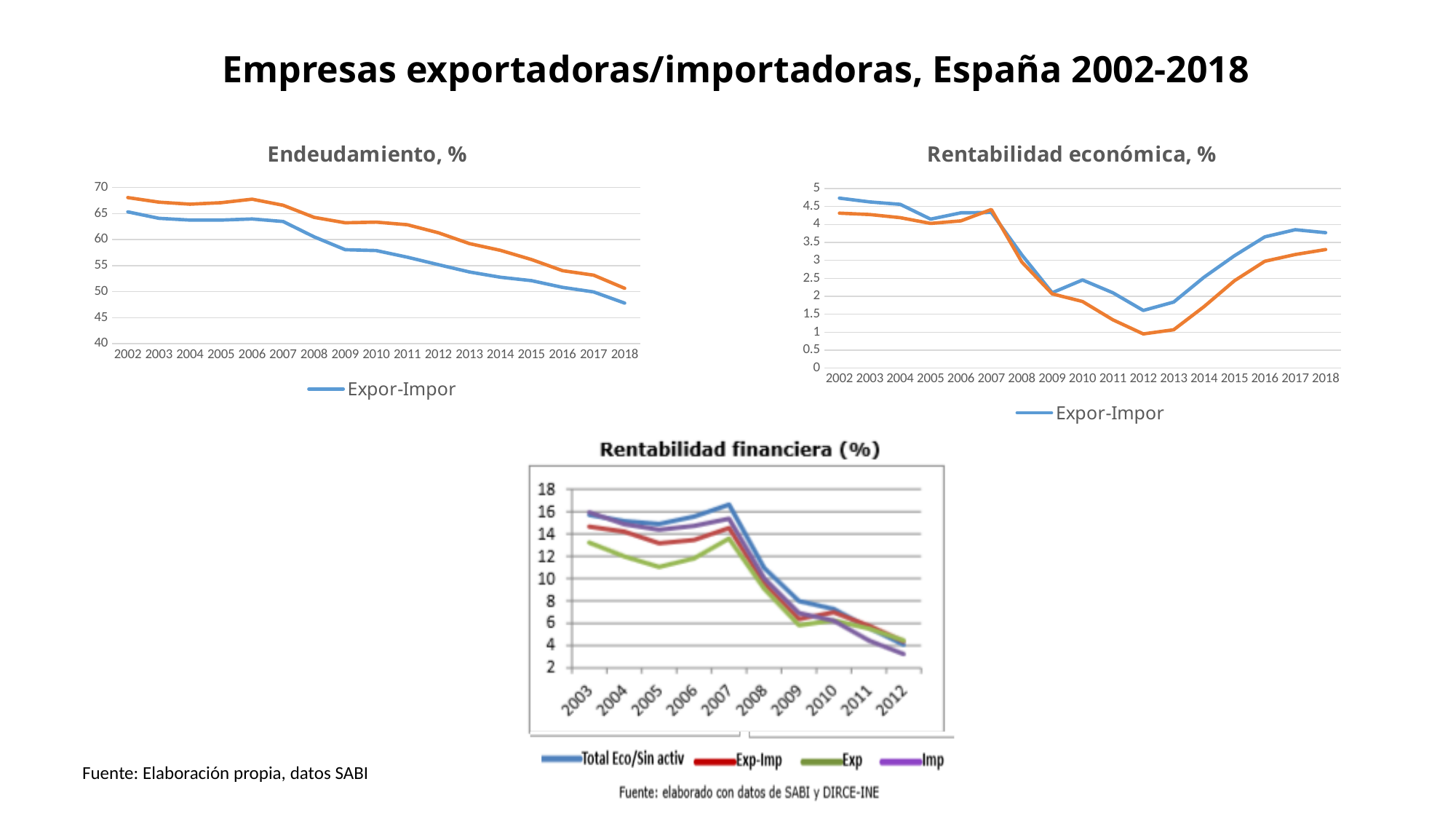
In the 'Endeudamiento, %' chart, do the values rise or fall from 2002 to 2018? fall In the 'Endeudamiento, %' chart, how many years are shown on the x axis? 17 In the 'Rentabilidad financiera (%)' chart, is the value of the 'Exp' series in 2005 greater or less than 12? less In the 'Endeudamiento, %' chart, is the value of the orange line in 2002 greater or less than 65? greater In the 'Rentabilidad financiera (%)' chart, how many years are shown on the x axis? 10 In the 'Endeudamiento, %' chart, is the value of the blue line in 2018 greater or less than 50? less In the 'Rentabilidad económica, %' chart, in which year does the blue line reach its lowest value? 2012 In the 'Rentabilidad financiera (%)' chart, in which year does the 'Total Eco/Sin activ' series reach its lowest value? 2012 What kind of chart is the 'Endeudamiento, %' chart? line chart How many series does the legend of the 'Rentabilidad financiera (%)' chart list? 4